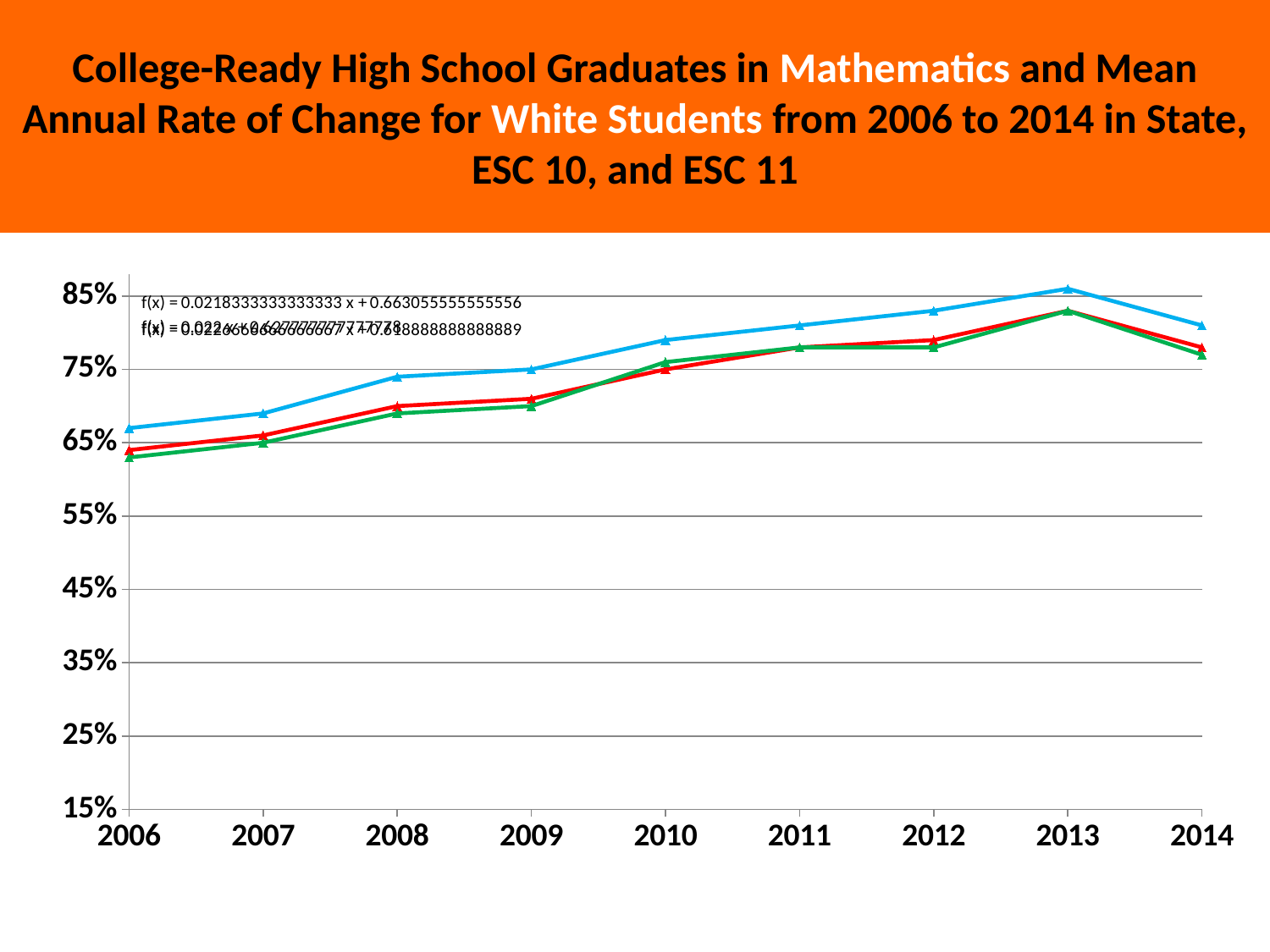
Is the value of the blue line in 2013 greater or less than 85%? greater What kind of chart is shown on the slide? line chart Which year is the first on the x axis? 2006 How many lines are plotted on the chart? 3 In which year is the green line at its lowest value? 2006 Is the value of the blue line in 2010 greater or less than 75%? greater In which year does the blue line reach its highest value? 2013 In 2008, which line has the higher value, the blue line or the green line? blue Is the value of the green line in 2006 greater or less than 65%? less Do the values of the blue line generally rise or fall from 2006 to 2013? rise How many years are plotted along the x axis? 9